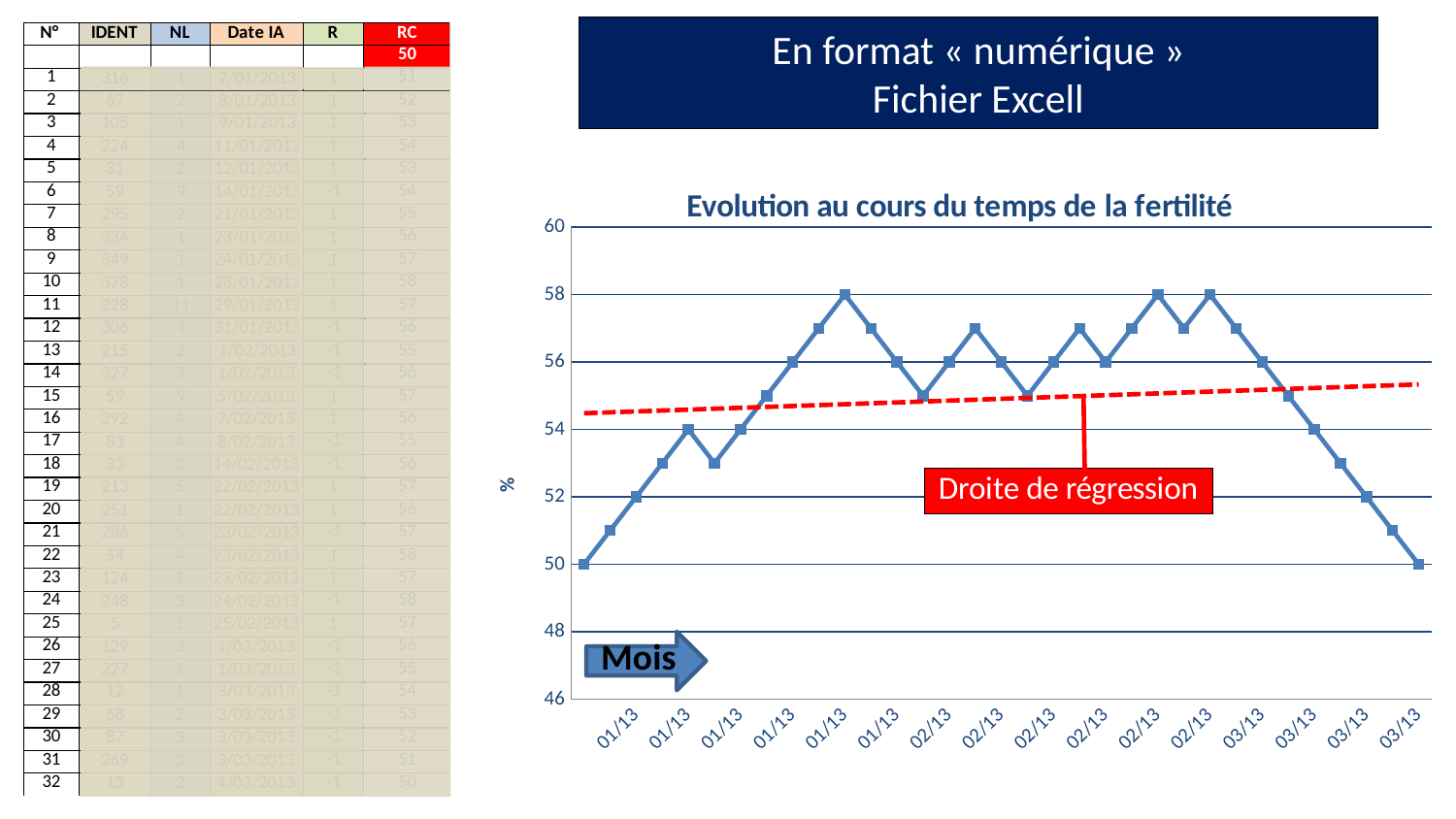
What is the value of the last point of the line, at the right edge of the chart? 50 Is the value of the highest peak of the line greater or less than 56? greater Is the value of the second point of the line greater or less than 52? less How many distinct month labels (e.g. 01/13) appear on the x axis? 3 Does the dashed red regression line rise or fall from left to right? rise What kind of chart is shown on the slide? line chart What is the lowest value reached by the plotted line? 50 What is the value of the first point of the line, at the left edge of the chart? 50 What is the title of the chart? Evolution au cours du temps de la fertilité What is the highest value reached by the plotted line? 58 What is the label of the vertical axis of the chart? % What is the difference between the highest and lowest values of the plotted line? 8